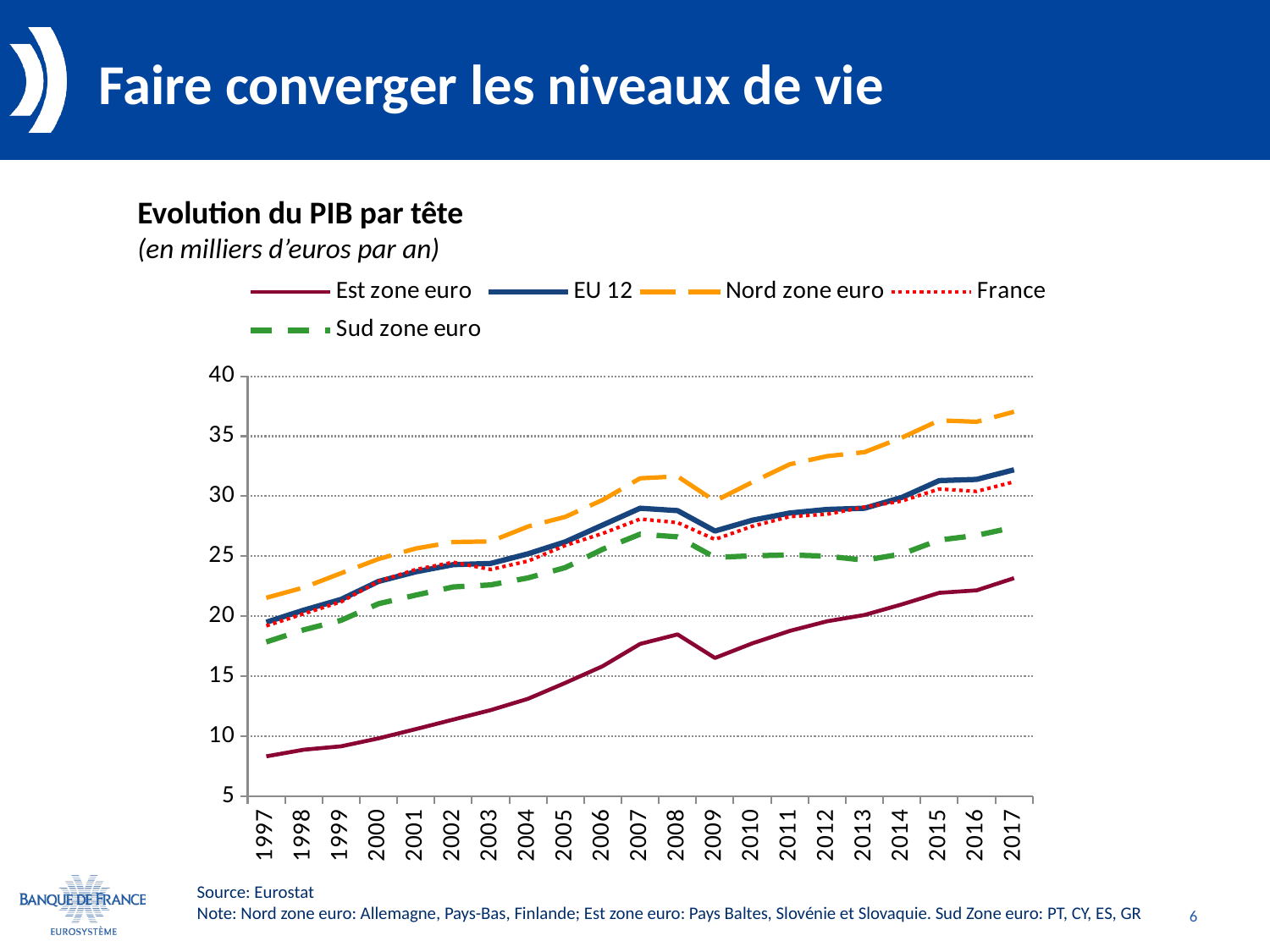
What kind of chart is shown on the slide? line chart Which series has the highest value in 2017? Nord zone euro In 2017, which is larger: Nord zone euro or Sud zone euro? Nord zone euro How many series does the legend list? 5 What is the title of the chart? Evolution du PIB par tête Is the value for Est zone euro in 2017 greater or less than 25? less Does the Est zone euro series rise or fall overall from 1997 to 2017? rise Is the value for Nord zone euro in 2017 greater or less than 35? greater How many years are shown on the x axis? 21 Which series has the lowest value in 2017? Est zone euro Is the value for Est zone euro in 1997 greater or less than 10? less